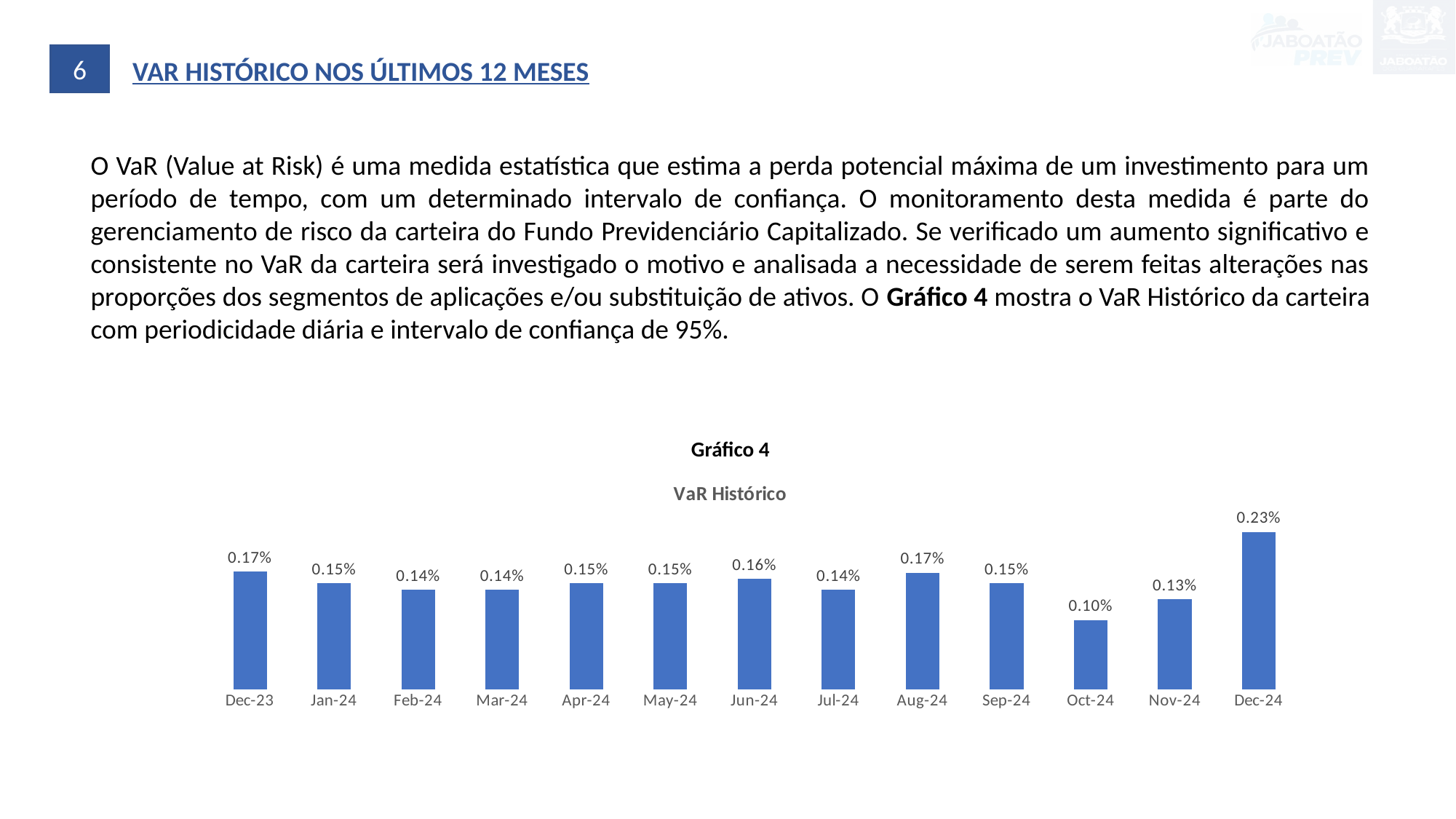
Which month has the highest VaR Histórico value? Dec-24 What is the title shown above the bars in Gráfico 4? VaR Histórico What is the VaR Histórico value for Nov-24? 0.13% What is the difference between the VaR Histórico values for Dec-24 and Nov-24? 0.10% What is the VaR Histórico value for Dec-24? 0.23% What is the VaR Histórico value for Jun-24? 0.16% What is the difference between the VaR Histórico values for Dec-24 and Oct-24? 0.13% How many months are shown on the VaR Histórico chart? 13 What is the VaR Histórico value for Oct-24? 0.10% What kind of chart is Gráfico 4? Bar chart Which is larger, the VaR Histórico value for Aug-24 or for Jul-24? Aug-24 Which month has the lowest VaR Histórico value? Oct-24